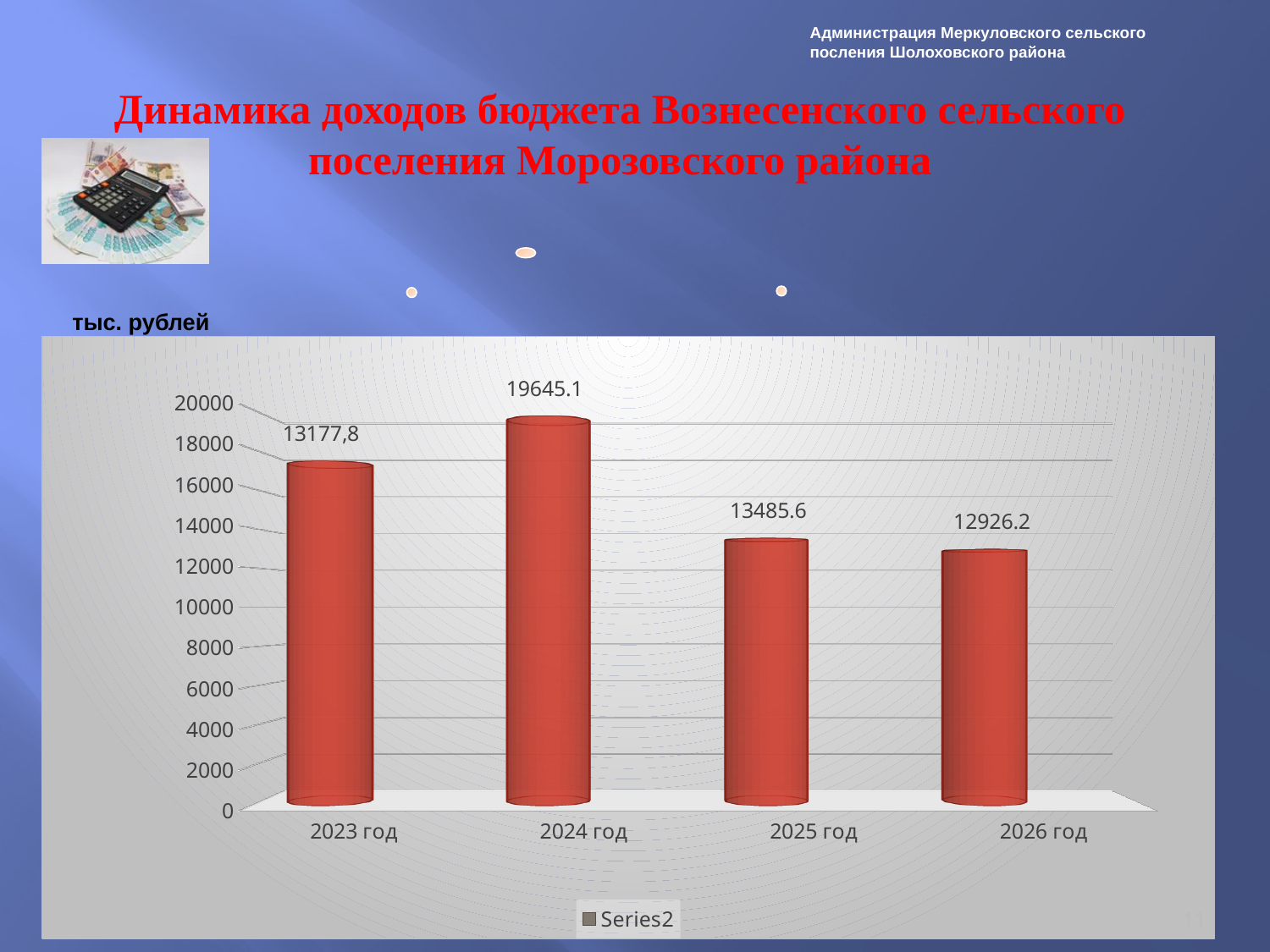
Which year has the highest value? 2024 год Which year has the lowest value? 2026 год How many series does the legend list? 1 Do the values rise or fall from 2024 год to 2026 год? fall What is the difference between the values for 2024 год and 2026 год? 6718.9 How many categories (years) are plotted on the chart? 4 Is the value for 2024 год greater or less than 18000? greater What is the value for 2025 год? 13485.6 What is the value for 2024 год? 19645.1 What is the value for 2026 год? 12926.2 Which is larger, the value for 2025 год or the value for 2026 год? 2025 год What type of chart is shown on the slide? Bar chart